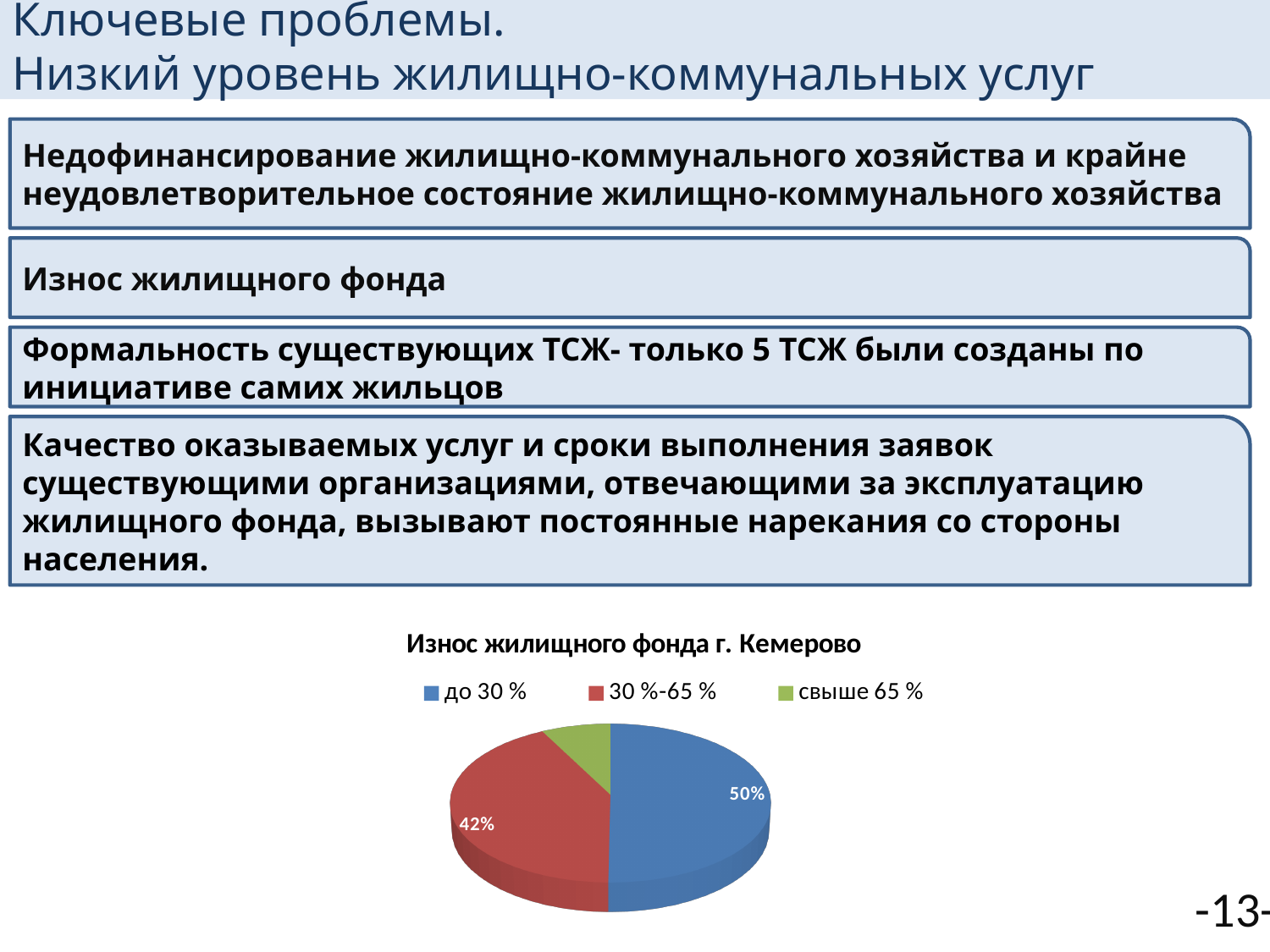
How many categories does the legend of the pie chart list? 3 By how many percentage points does the "до 30 %" slice exceed the "30 %-65 %" slice? 8 Which category has the smallest slice in the pie chart? свыше 65 % How many slices does the pie chart have? 3 What colour is the slice for "свыше 65 %" in the pie chart? green Which slice is larger in the pie chart: "30 %-65 %" or "свыше 65 %"? 30 %-65 % What percentage of the pie chart is labelled for the category "30 %-65 %"? 42% What type of chart is shown on the slide? pie chart Which slice is larger in the pie chart: "до 30 %" or "30 %-65 %"? до 30 % Which category has the largest slice in the pie chart? до 30 % What is the title of the chart on the slide? Износ жилищного фонда г. Кемерово What percentage of the pie chart is labelled for the category "до 30 %"? 50%